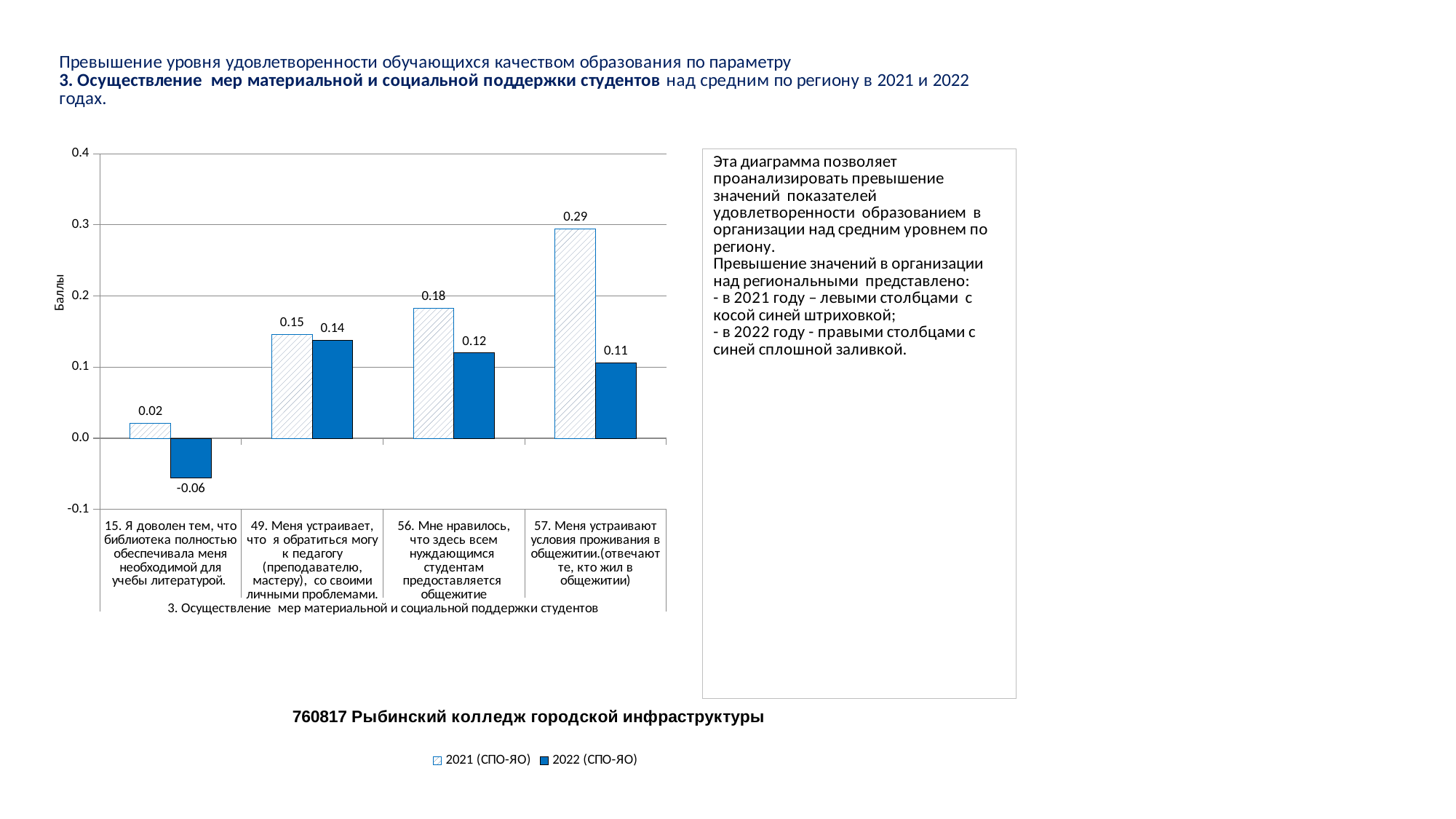
What is the 2021 (СПО-ЯО) value for question 57 (условия проживания в общежитии)? 0.29 How many series does the legend list? 2 Which category has the highest 2021 (СПО-ЯО) value? 57. Меня устраивают условия проживания в общежитии For question 56, which series has the larger value, 2021 (СПО-ЯО) or 2022 (СПО-ЯО)? 2021 (СПО-ЯО) Which category has the lowest 2022 (СПО-ЯО) value? 15. Я доволен тем, что библиотека полностью обеспечивала меня необходимой для учебы литературой How many categories (questions) are shown on the x axis? 4 What is the 2022 (СПО-ЯО) value for question 15 (библиотека полностью обеспечивала меня необходимой для учебы литературой)? -0.06 What is the 2022 (СПО-ЯО) value for question 56 (всем нуждающимся студентам предоставляется общежитие)? 0.12 What is the label of the vertical axis? Баллы What is the difference between the 2021 and 2022 values for question 57? 0.18 Is the 2021 (СПО-ЯО) value for question 49 greater or less than 0.1? greater What type of chart is shown on the slide? bar chart